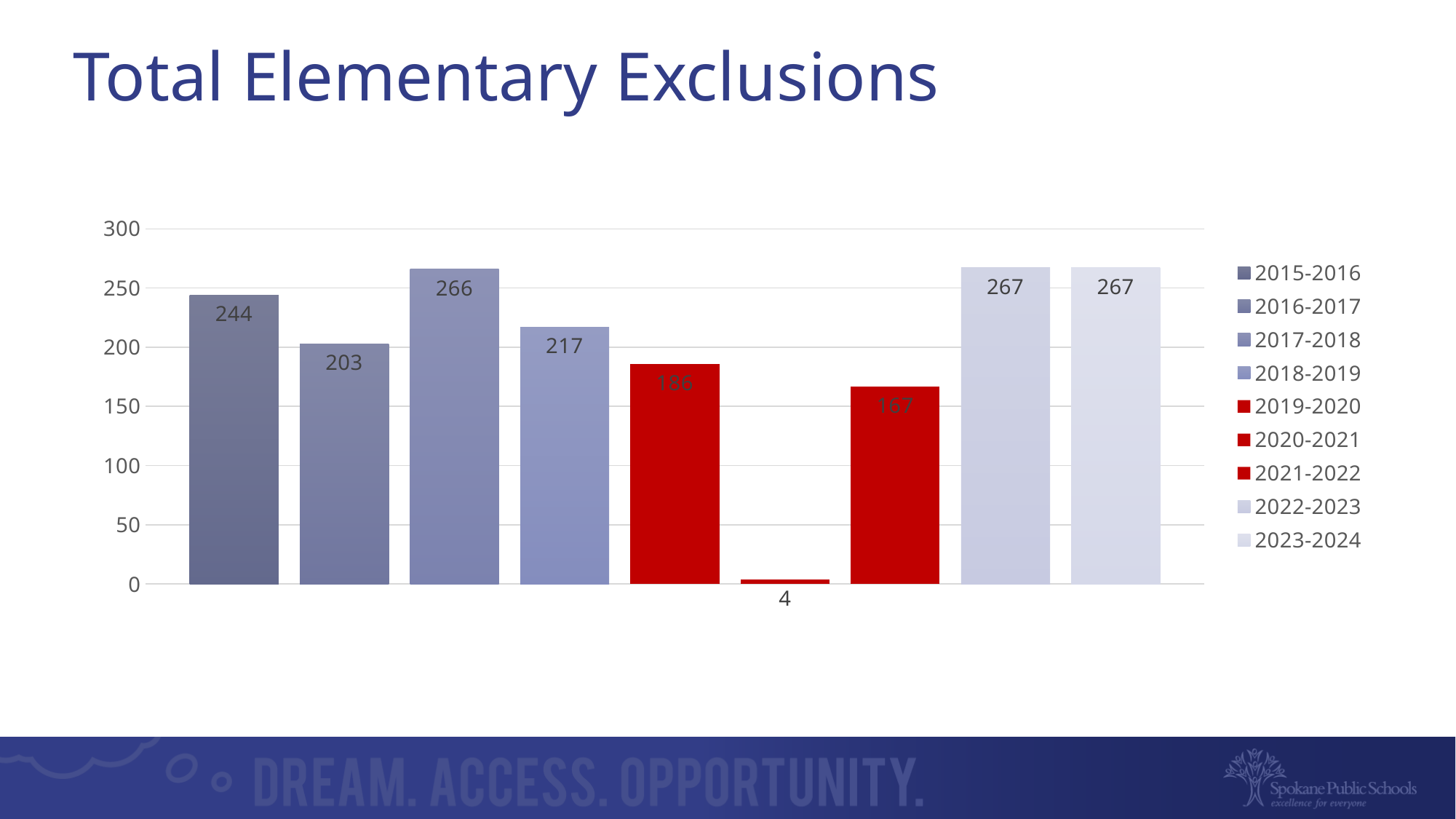
What is the value for 2015-2016? 244 What kind of chart is shown on the slide? Bar chart What is the value for 2023-2024? 267 How many bars are plotted in the chart? 9 How many entries does the legend list? 9 Which school year has the lowest number of exclusions? 2020-2021 What is the value for 2020-2021? 4 What is the title of the chart? Total Elementary Exclusions What is the difference between the values for 2015-2016 and 2016-2017? 41 What is the difference between the values for 2022-2023 and 2021-2022? 100 Which is larger, the value for 2017-2018 or the value for 2019-2020? 2017-2018 What is the value for 2018-2019? 217